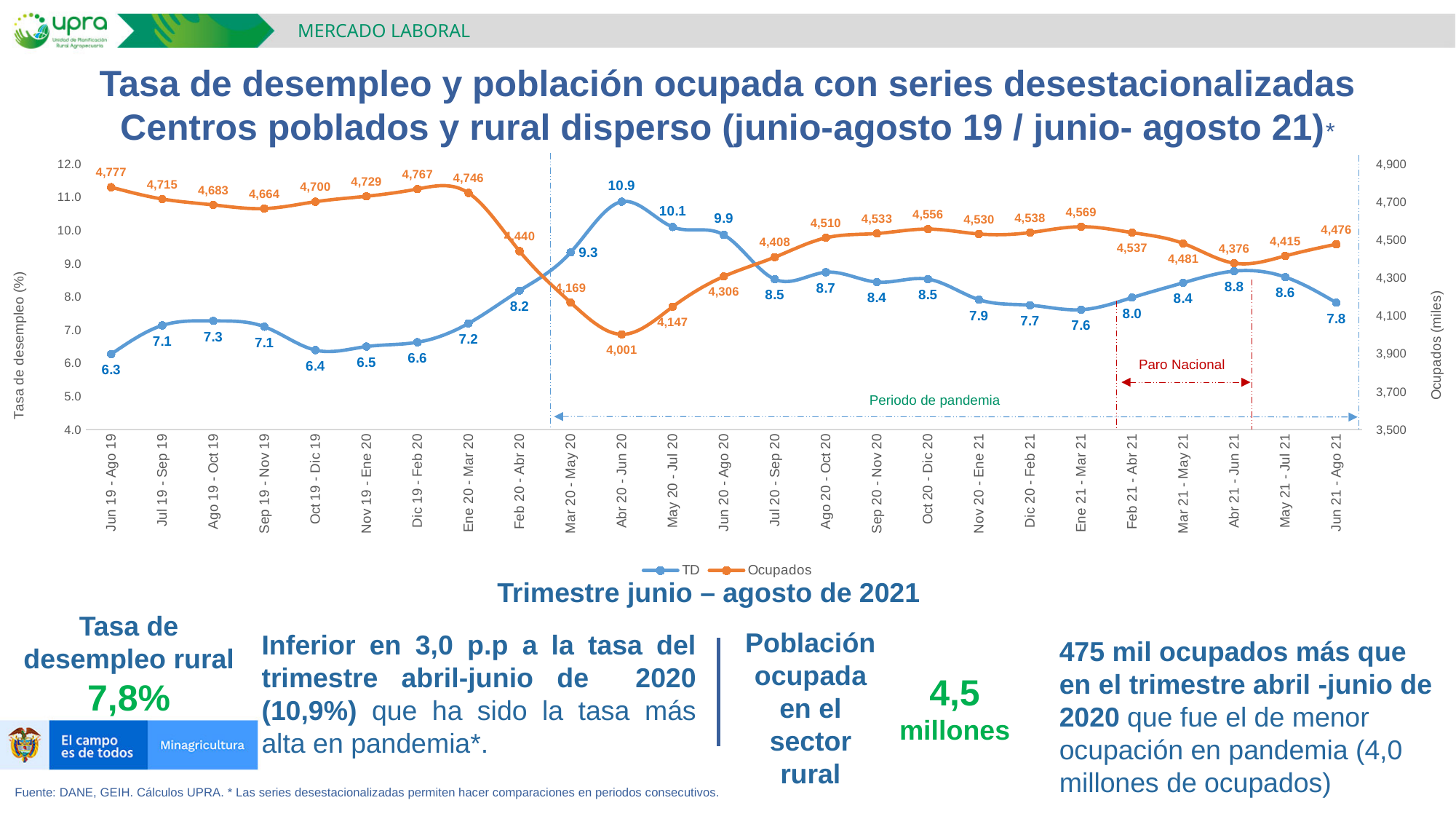
In which period is the Ocupados series at its highest? Jun 19 - Ago 19 How many periods are shown on the x axis? 25 In which period does the TD series reach its highest value? Abr 20 - Jun 20 What is the Ocupados value for Jun 21 - Ago 21? 4,476 What is the difference between the highest and lowest Ocupados values (4,777 and 4,001)? 776 What is the TD value for Jun 19 - Ago 19? 6.3 Which is larger, the TD value for Mar 20 - May 20 or for Jul 20 - Sep 20? Mar 20 - May 20 What are the names of the two series in the legend? TD and Ocupados What is the TD value for Abr 20 - Jun 20? 10.9 In which period is the Ocupados series at its lowest? Abr 20 - Jun 20 How many series does the legend list? 2 What type of chart is shown on the slide? line chart